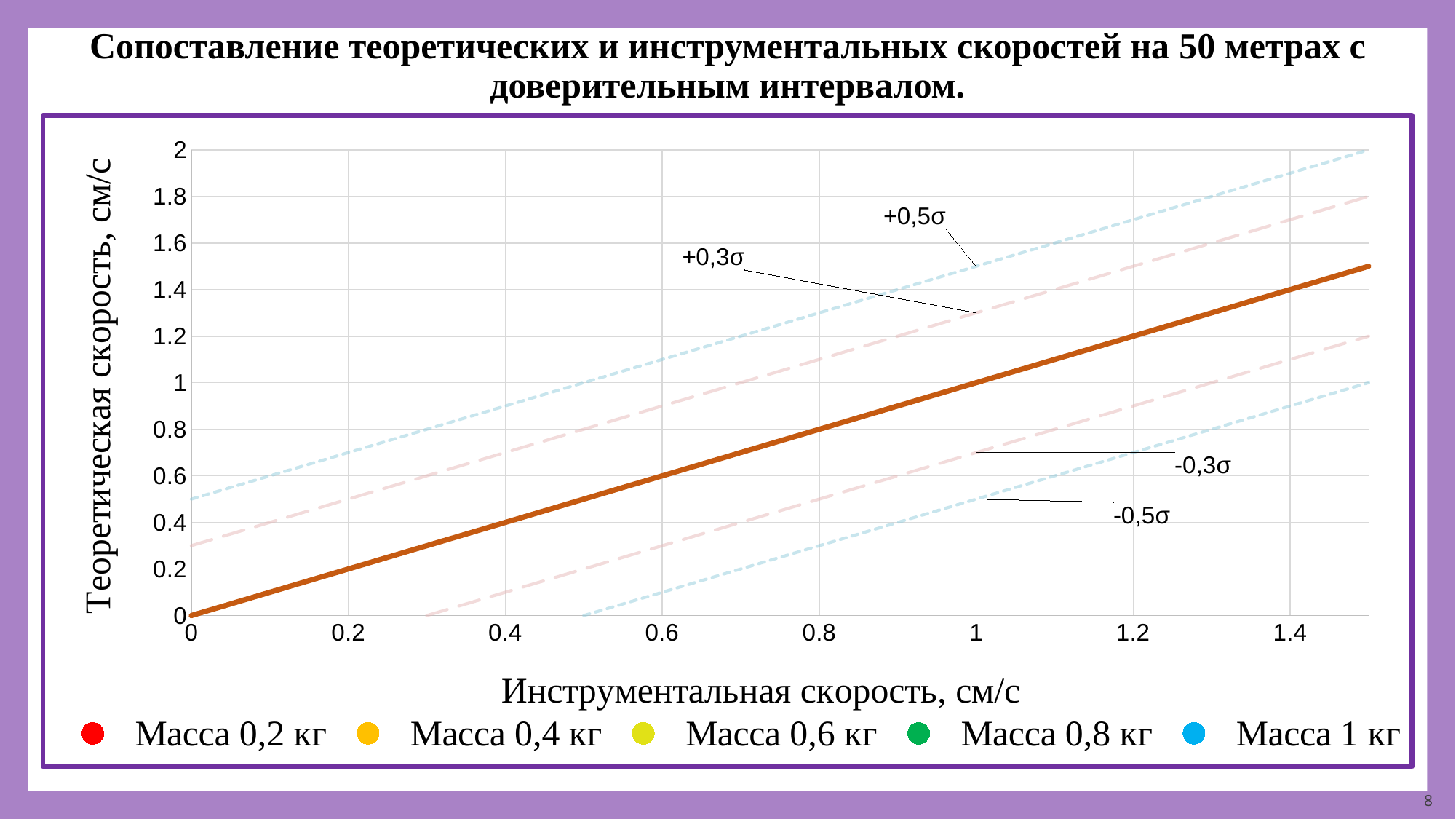
How many series does the legend list? 5 At an instrumental speed of 1 cm/s, which line is higher: +0,5σ or +0,3σ? +0,5σ Is the value of the solid orange line at an instrumental speed of 1.4 greater or less than 1.2? greater Does the solid orange line rise or fall as instrumental speed increases? rises What is the label of the x axis? Инструментальная скорость, см/с What kind of chart is shown on the slide? line chart What is the value of the solid orange line at an instrumental speed of 1 cm/s? 1 What is the value of the +0,5σ line at an instrumental speed of 0? 0.5 What is the label of the y axis? Теоретическая скорость, см/с